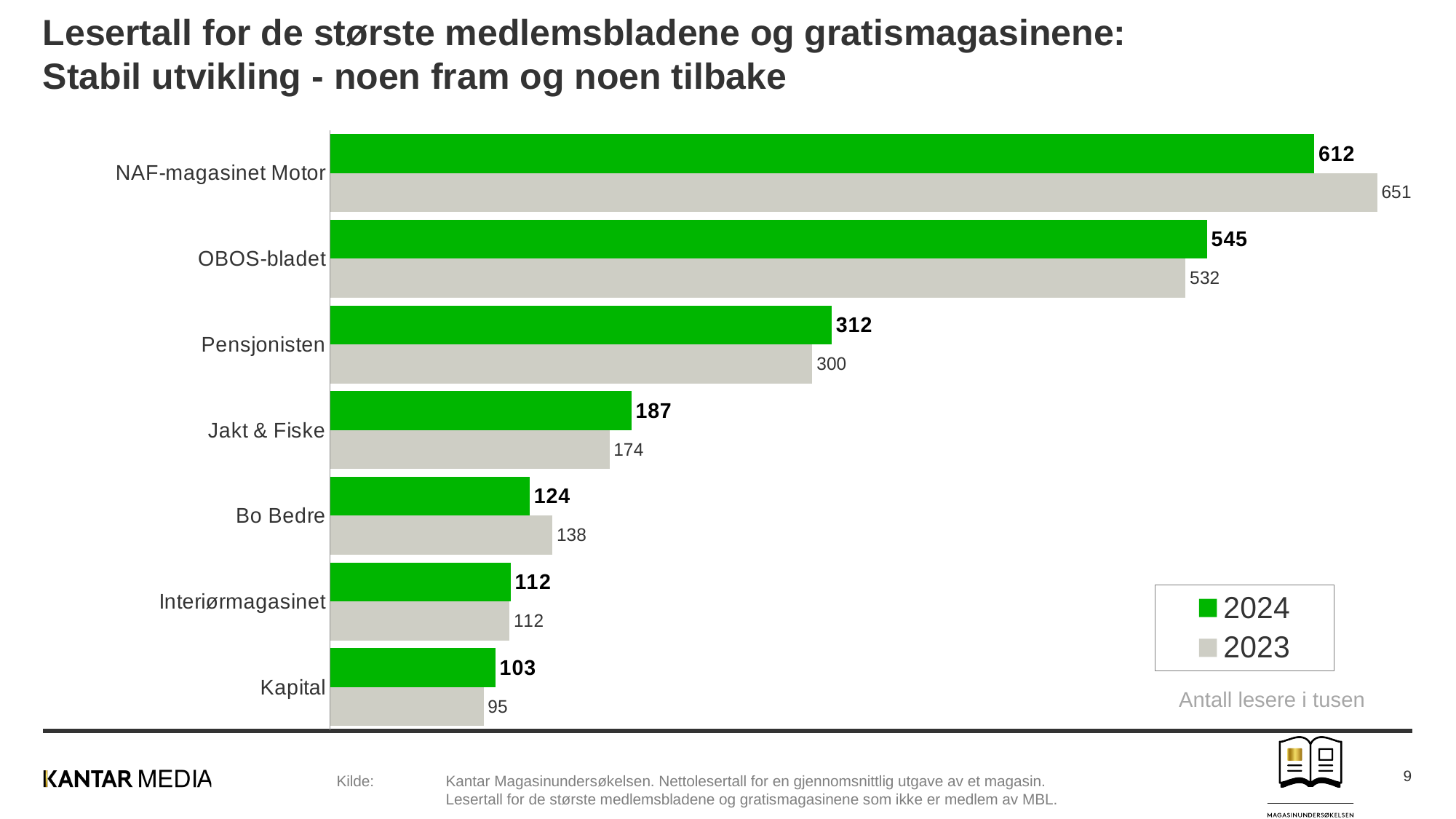
What is the 2023 value for Pensjonisten? 300 What is the 2024 value for Kapital? 103 Which is larger for Bo Bedre, the 2024 value or the 2023 value? 2023 Which magazine has the lowest 2023 value? Kapital Which is larger for OBOS-bladet, the 2024 value or the 2023 value? 2024 Which magazine has the highest 2024 value? NAF-magasinet Motor How many magazines are shown in the chart? 7 How many series does the legend list? 2 What is the 2024 value for NAF-magasinet Motor? 612 What kind of chart is shown on the slide? Bar chart What is the difference between the 2024 and 2023 values for Jakt & Fiske? 13 What is the difference between the 2023 and 2024 values for NAF-magasinet Motor? 39